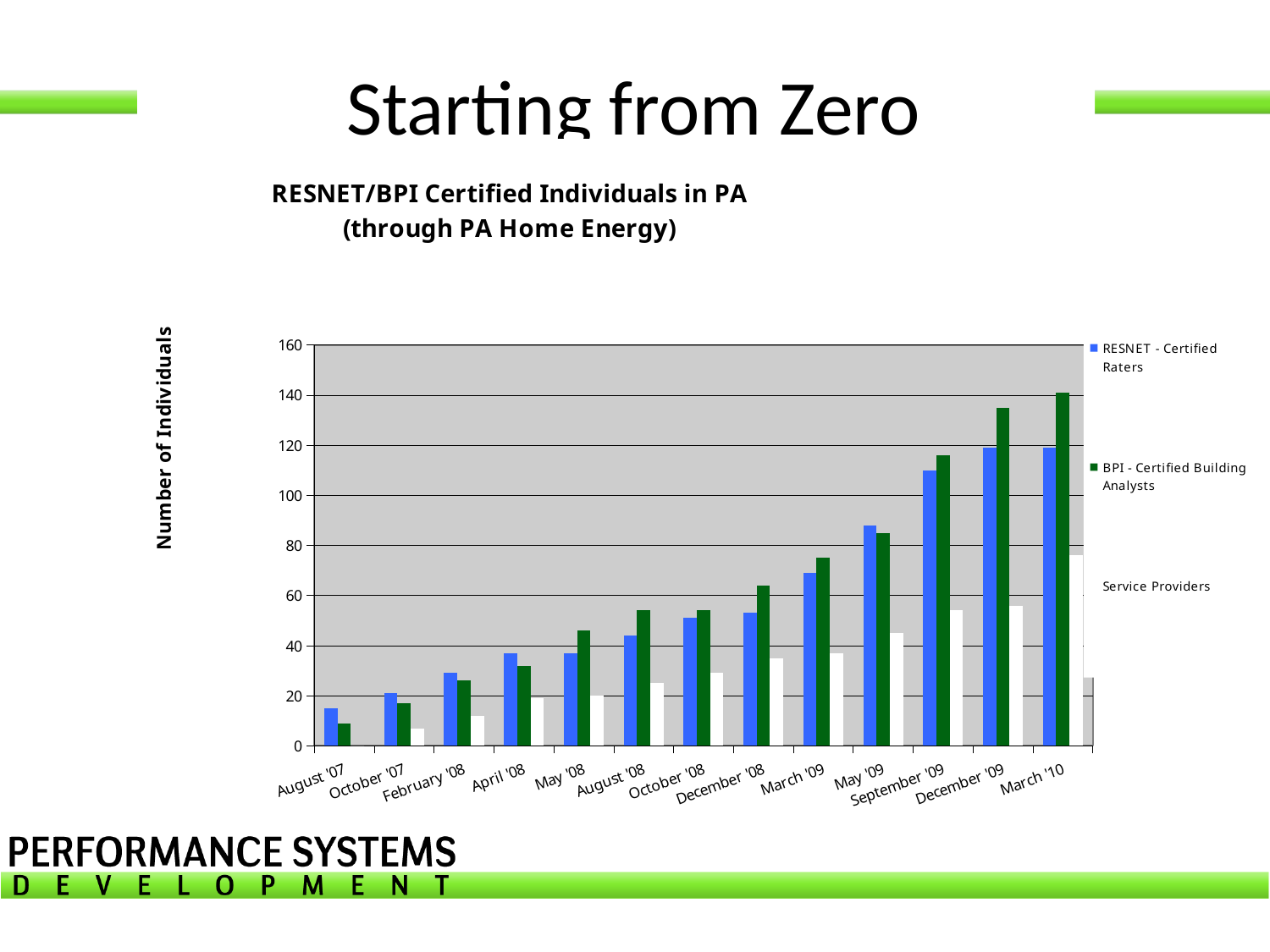
What kind of chart is shown on the slide? Bar chart How many time periods are shown along the x axis? 13 In which period is the value for Service Providers highest? March '10 Is the value for Service Providers in March '10 greater or less than 60? greater Is the value for BPI - Certified Building Analysts in December '09 greater or less than 120? greater How many series does the legend list? 3 In August '07, which is larger: RESNET - Certified Raters or BPI - Certified Building Analysts? RESNET - Certified Raters In December '09, which is larger: RESNET - Certified Raters or BPI - Certified Building Analysts? BPI - Certified Building Analysts In which period is the value for BPI - Certified Building Analysts highest? March '10 Do the values for BPI - Certified Building Analysts generally rise or fall from August '07 to March '10? Rise Is the value for RESNET - Certified Raters in September '09 greater or less than 100? greater In which period is the value for BPI - Certified Building Analysts lowest? August '07